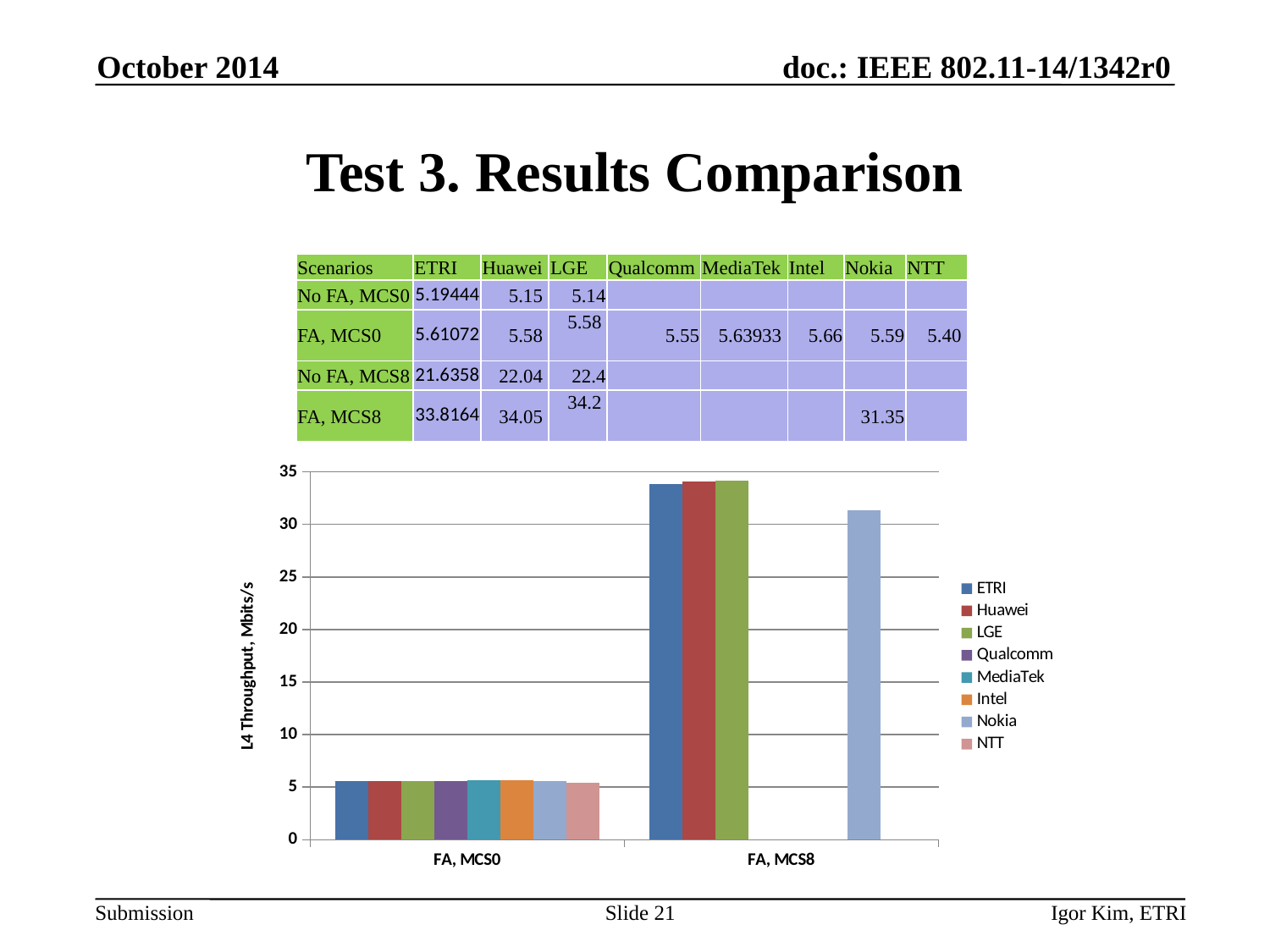
Which is larger in the FA, MCS8 category: the Huawei bar or the Nokia bar? Huawei Which is larger: the Nokia bar for FA, MCS0 or the Nokia bar for FA, MCS8? FA, MCS8 What kind of chart is shown on the slide? bar chart How many series have a bar plotted in the FA, MCS8 category? 4 How many scenario categories are shown on the x axis of the chart? 2 What is the label of the chart's vertical axis? L4 Throughput, Mbits/s Among the bars plotted in the FA, MCS8 category, which series has the lowest value? Nokia How many series does the chart legend list? 8 Is the value for ETRI in the FA, MCS0 category greater or less than 10? less Is the value for Nokia in the FA, MCS8 category greater or less than 30? greater Is the value for ETRI in the FA, MCS8 category greater or less than 35? less According to the table on the slide, what is the Nokia value for the FA, MCS8 scenario? 31.35